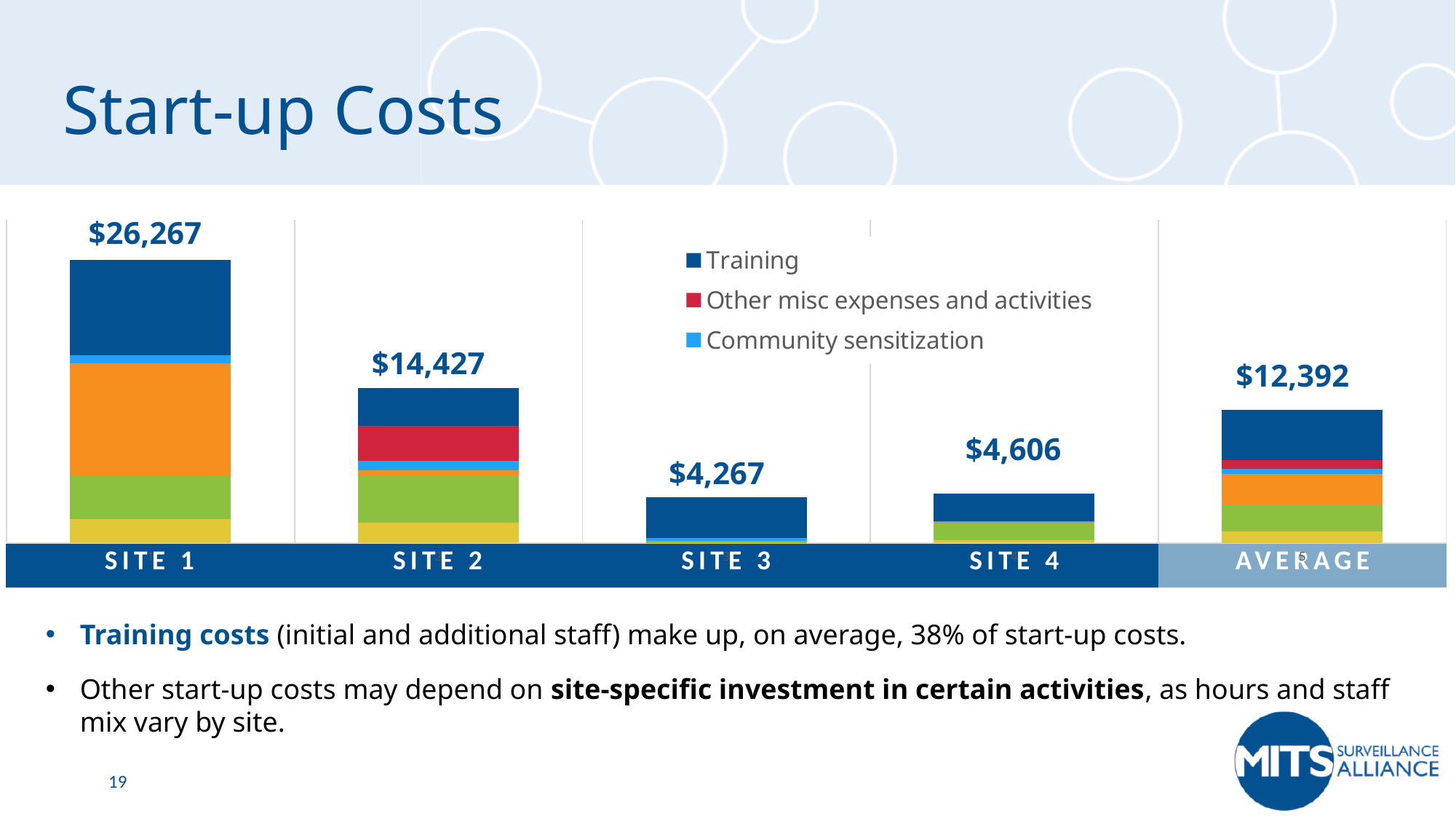
What is the total start-up cost shown for Site 2? $14,427 Which site has the lowest total start-up cost? Site 3 Which has a larger total start-up cost, Site 3 or Site 4? Site 4 How many categories are shown along the x axis of the chart? 5 What is the difference between the total start-up costs of Site 4 and Site 3? $339 What is the total start-up cost shown for Site 3? $4,267 What is the Average start-up cost shown on the chart? $12,392 What kind of chart is shown on the slide? Stacked bar chart Which site has the highest total start-up cost? Site 1 What is the total start-up cost shown for Site 1? $26,267 What is the difference between the total start-up costs of Site 1 and Site 2? $11,840 What is the total start-up cost shown for Site 4? $4,606